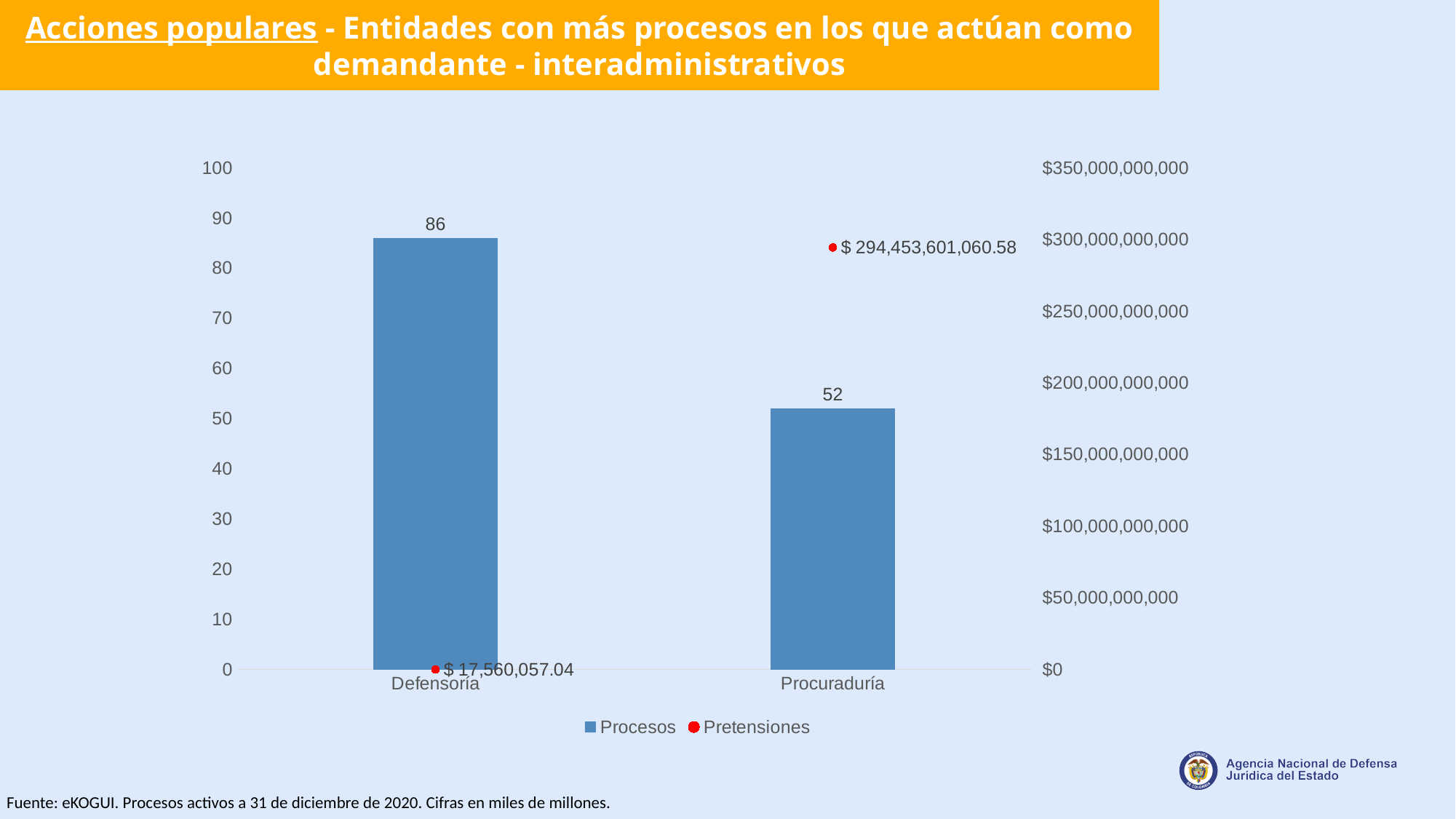
How many Procesos does Procuraduría have? 52 What colour are the Pretensiones markers? Red What is the Pretensiones value for Defensoría? $ 17,560,057.04 How many series does the legend list? 2 How many Procesos does Defensoría have? 86 Which entity has the lowest Pretensiones value? Defensoría How many entities are shown on the chart? 2 What is the Pretensiones value for Procuraduría? $ 294,453,601,060.58 Which entity has the highest number of Procesos? Defensoría Is the Pretensiones value for Procuraduría greater or less than $250,000,000,000? greater Which entity has more Procesos, Defensoría or Procuraduría? Defensoría What is the difference in Procesos between Defensoría and Procuraduría? 34